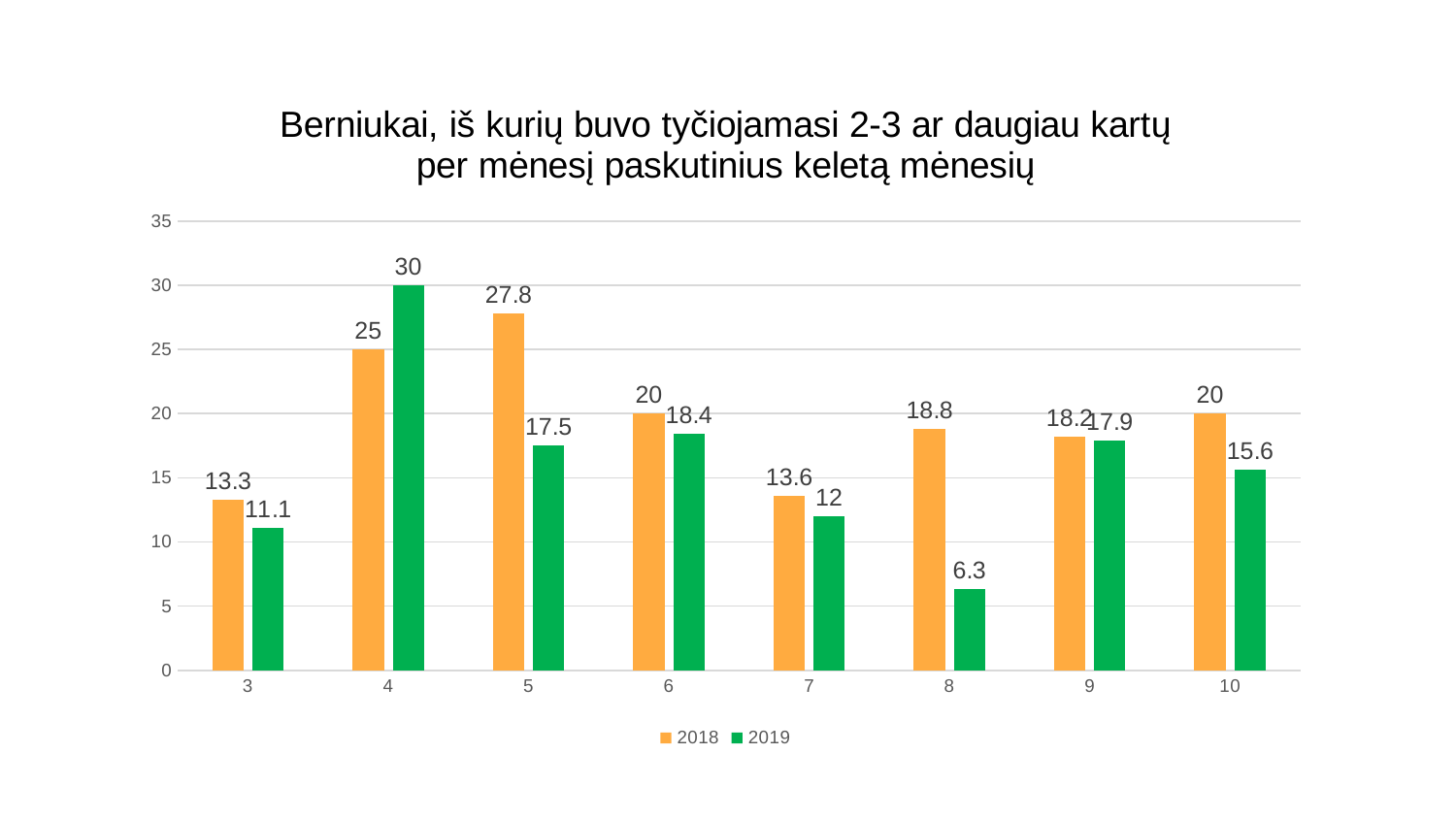
Which category has the lowest 2019 value? 8 What kind of chart is shown on the slide? Bar chart How many categories are shown on the x axis? 8 Which colour represents the 2019 series? Green What is the difference between the 2018 and 2019 values for category 8? 12.5 What is the 2019 value for category 8? 6.3 What is the 2019 value for category 10? 15.6 Which category has the highest 2019 value? 4 Which is larger for category 4, the 2018 value or the 2019 value? 2019 Which category has the highest 2018 value? 5 What is the 2018 value for category 5? 27.8 How many series does the legend list? 2